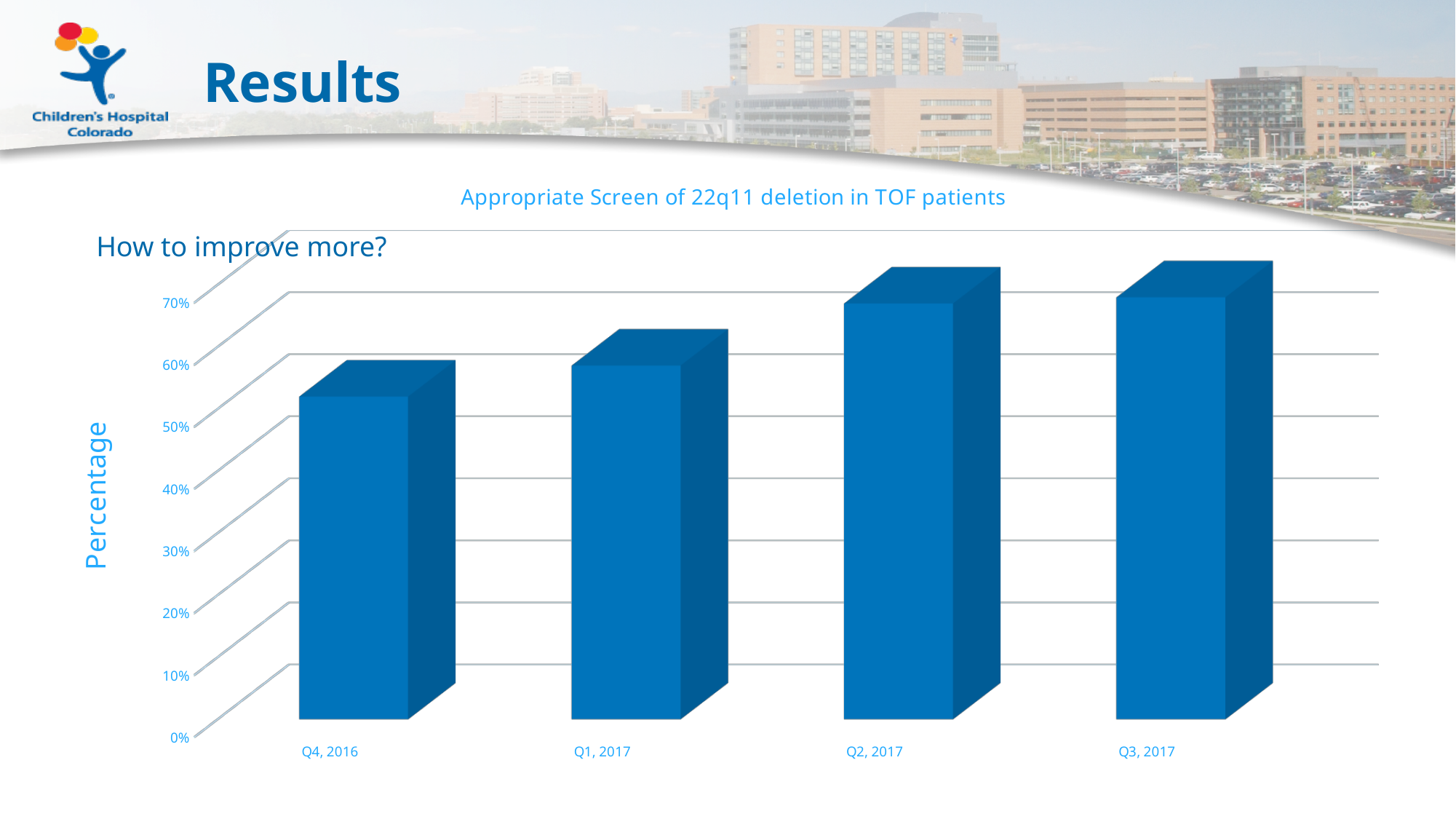
Is the value for Q2, 2017 greater or less than 60%? greater What is the title of the chart? Appropriate Screen of 22q11 deletion in TOF patients Is the value for Q4, 2016 greater or less than 60%? less Is the value for Q3, 2017 greater or less than 60%? greater Do the values generally rise or fall from Q4, 2016 to Q3, 2017? rise Which is larger, the value for Q4, 2016 or the value for Q2, 2017? Q2, 2017 What is the label of the vertical axis? Percentage Which quarter has the lowest value in the chart? Q4, 2016 How many quarters are plotted on the x axis of the chart? 4 What kind of chart is shown on the slide? bar chart